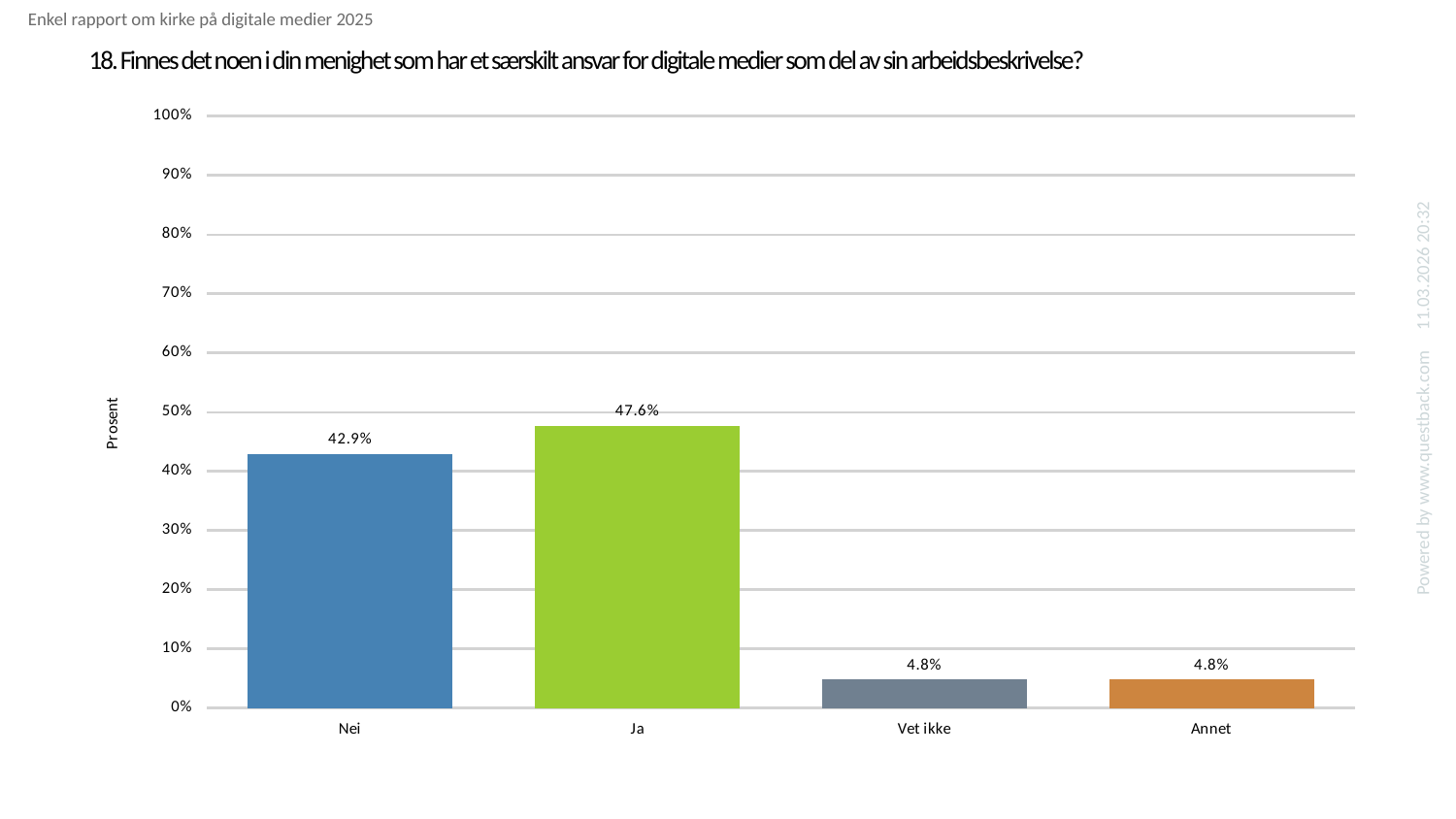
What is the value for Annet? 4.8% What is the value for Ja? 47.6% How many categories are shown on the x axis? 4 What kind of chart is shown on the slide? bar chart Which category has the highest value? Ja What colour is the bar for Ja? green What is the value for Nei? 42.9% What is the value for Vet ikke? 4.8% Which is larger, the value for Nei or the value for Vet ikke? Nei Is the value for Ja greater or less than 50%? less What is the difference between the values for Ja and Nei? 4.7% What is the label of the y axis? Prosent